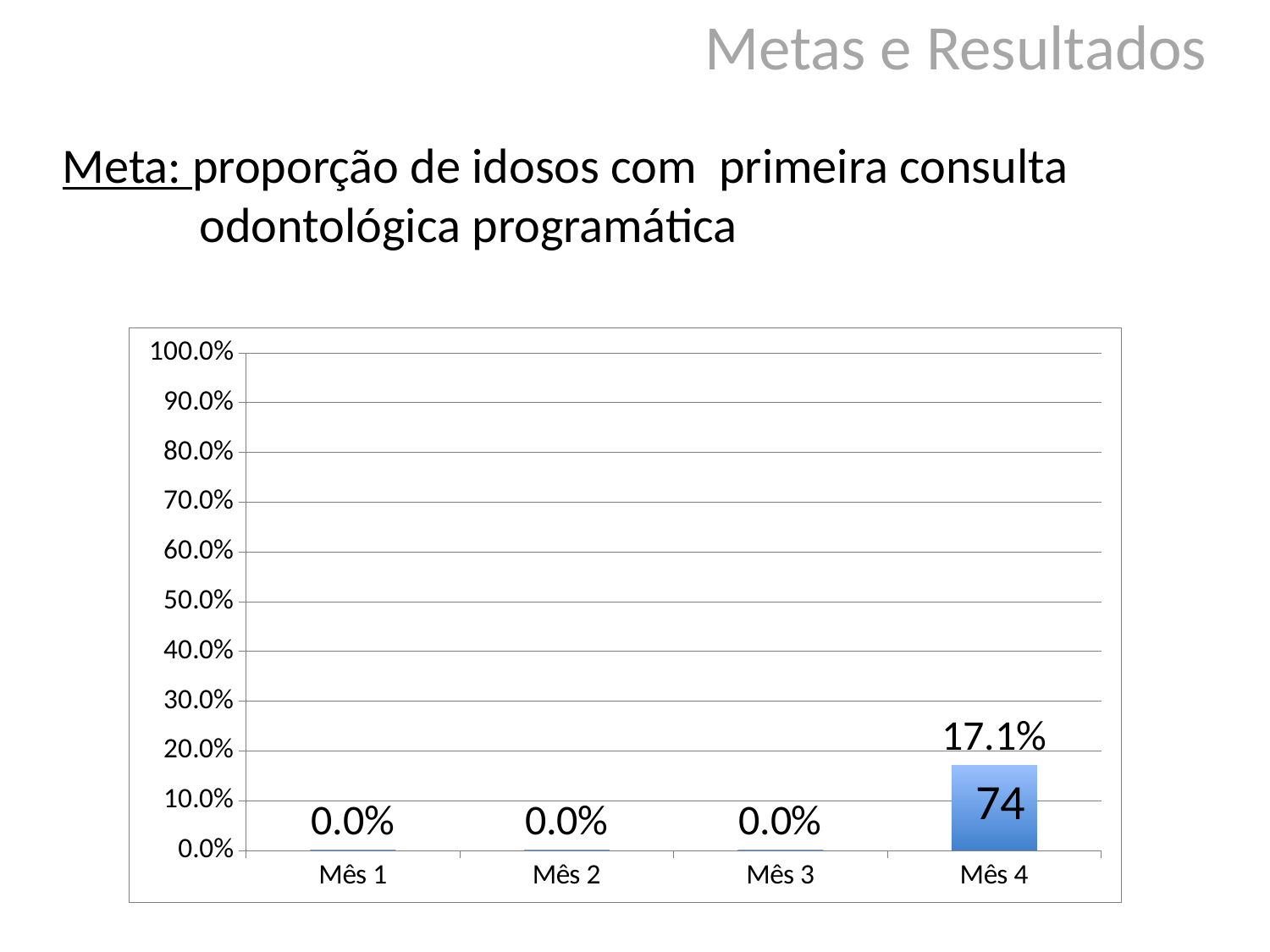
What number is printed inside the bar for Mês 4? 74 Is the value for Mês 4 greater or less than 20.0%? less How many months are shown on the x axis? 4 What is the maximum value shown on the y axis? 100.0% What is the difference between the values for Mês 4 and Mês 3? 17.1% What is the value for Mês 4? 17.1% Which is larger, the value for Mês 2 or the value for Mês 4? Mês 4 What is the value for Mês 1? 0.0% Do the values rise or fall from Mês 3 to Mês 4? rise What is the value for Mês 3? 0.0% What kind of chart is shown on the slide? bar chart Which month has the highest value? Mês 4